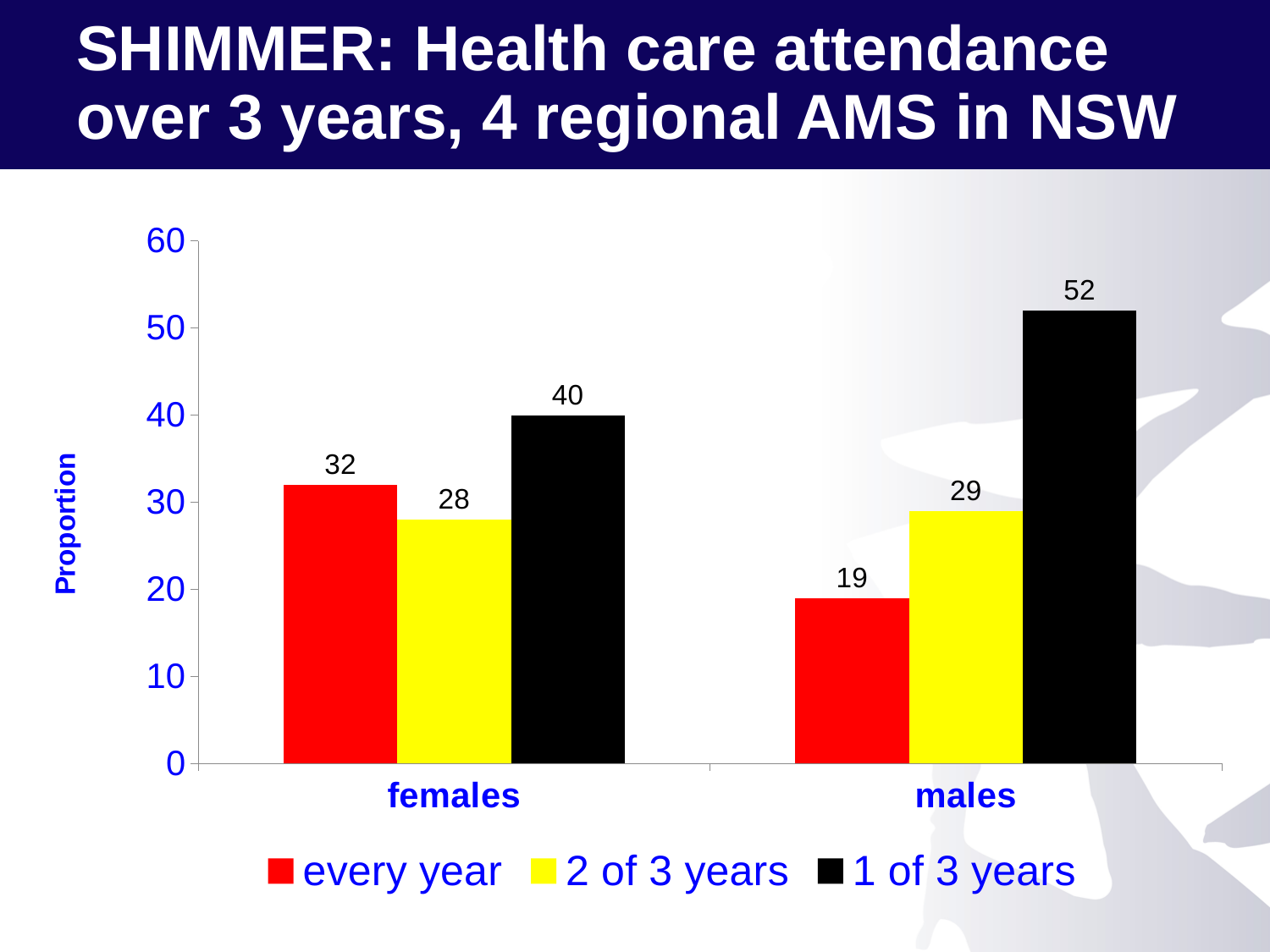
What is the label of the y axis? Proportion What kind of chart is shown on the slide? bar chart Which series has the lowest value for females? 2 of 3 years Which is larger: the 'every year' value for females or for males? females Is the 'every year' value for males greater or less than 20? less How many categories are shown on the x axis? 2 What is the value for females in the 'every year' series? 32 What is the difference between the '1 of 3 years' values for males and females? 12 How many series does the legend list? 3 Which series has the highest value for males? 1 of 3 years What is the value for males in the '1 of 3 years' series? 52 What is the value for males in the '2 of 3 years' series? 29